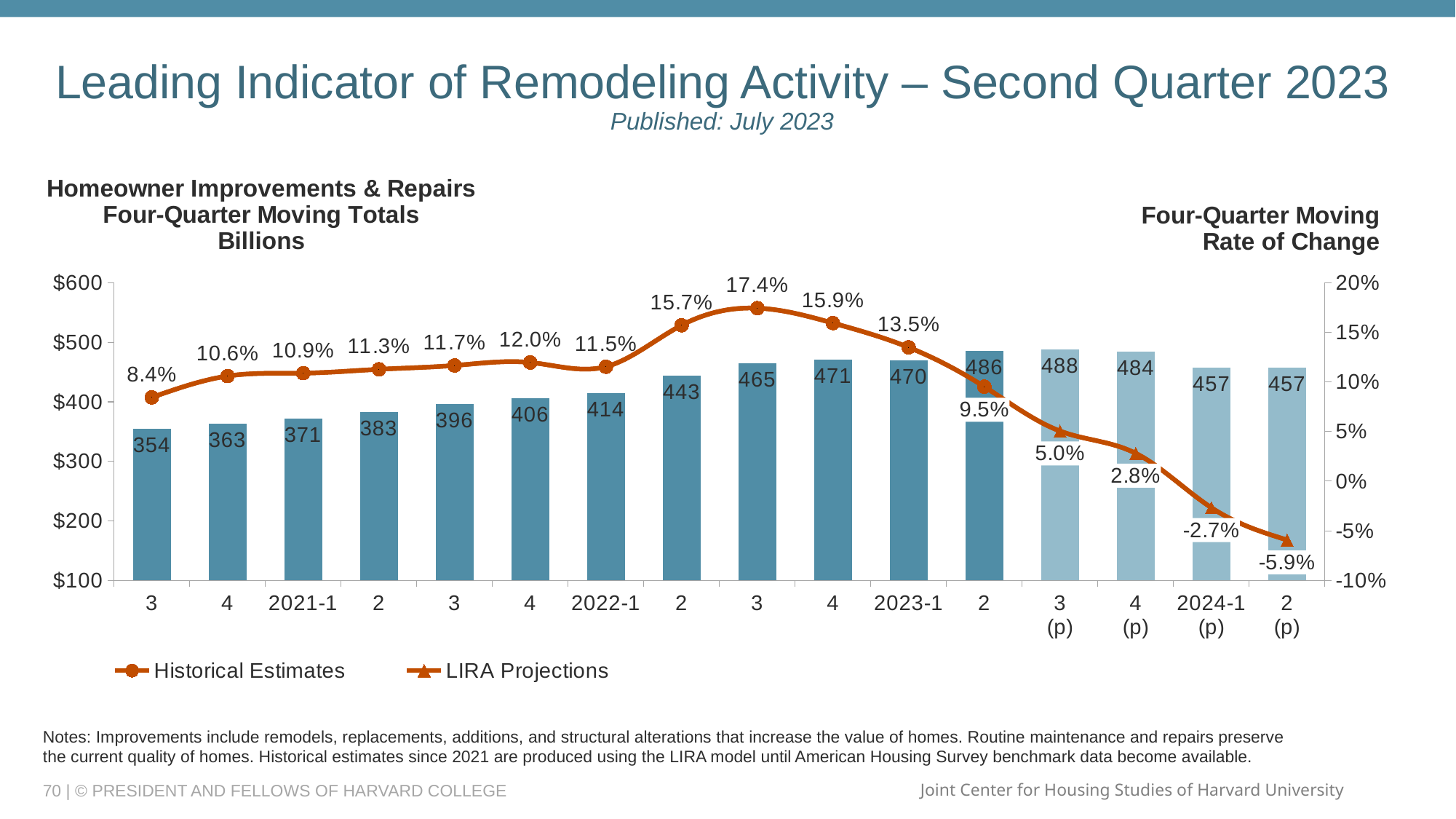
Does the four-quarter moving rate of change rise or fall from 2022-3 to 2024-2 (p)? Fall How many quarters are shown on the x axis? 16 Which is larger, the four-quarter moving total for 2022-2 or for 2021-4? 2022-2 What is the difference between the four-quarter moving totals for 2023-2 and 2023-1? 16 Which quarter has the lowest four-quarter moving rate of change? 2024-2 (p) (-5.9%) How many series does the legend list? 2 Which quarter has the highest four-quarter moving total? 2023-3 (p) (488) What are the two series named in the legend? Historical Estimates and LIRA Projections What is the four-quarter moving rate of change for 2023-1? 13.5% What is the four-quarter moving total for 2022-1? 414 What kind of chart is shown on the slide? Combined bar and line chart Which quarter has the highest four-quarter moving rate of change? 2022-3 (17.4%)